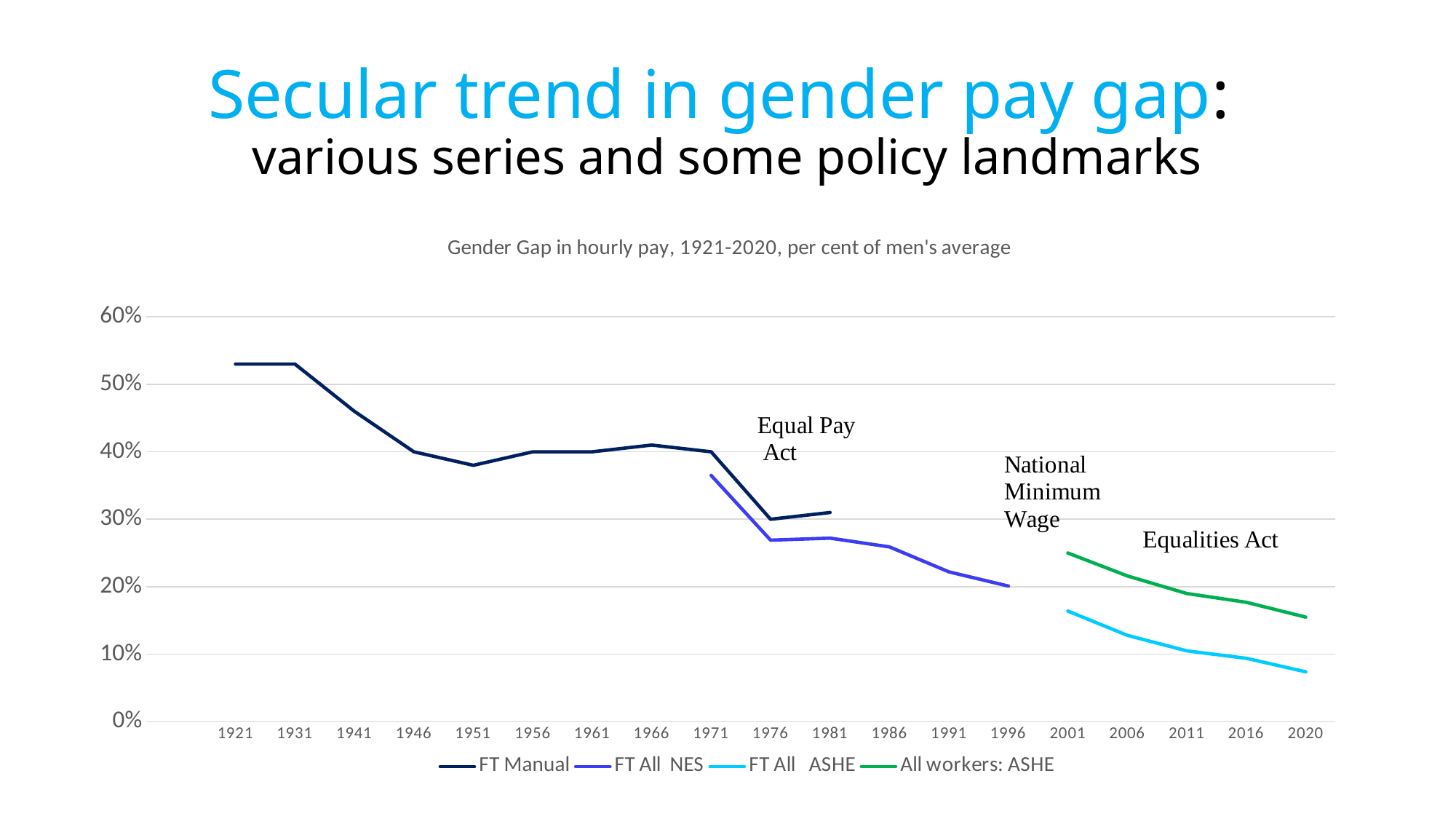
Is the value for FT All ASHE in 2020 greater or less than 10%? less Is the value for All workers: ASHE in 2001 greater or less than 20%? greater Which series is drawn in green? All workers: ASHE Is the value for FT Manual in 1921 greater or less than 50%? greater How many series does the legend list? 4 Does the FT All ASHE series rise or fall from 2001 to 2020? fall In which year does the FT Manual series reach its highest value? 1921 and 1931 What kind of chart is shown on the slide? line chart What is the chart's title? Gender Gap in hourly pay, 1921-2020, per cent of men's average How many year labels are shown on the x axis? 19 Which series has the lowest value in 2020? FT All ASHE Which series has the highest value in 1971, FT Manual or FT All NES? FT Manual